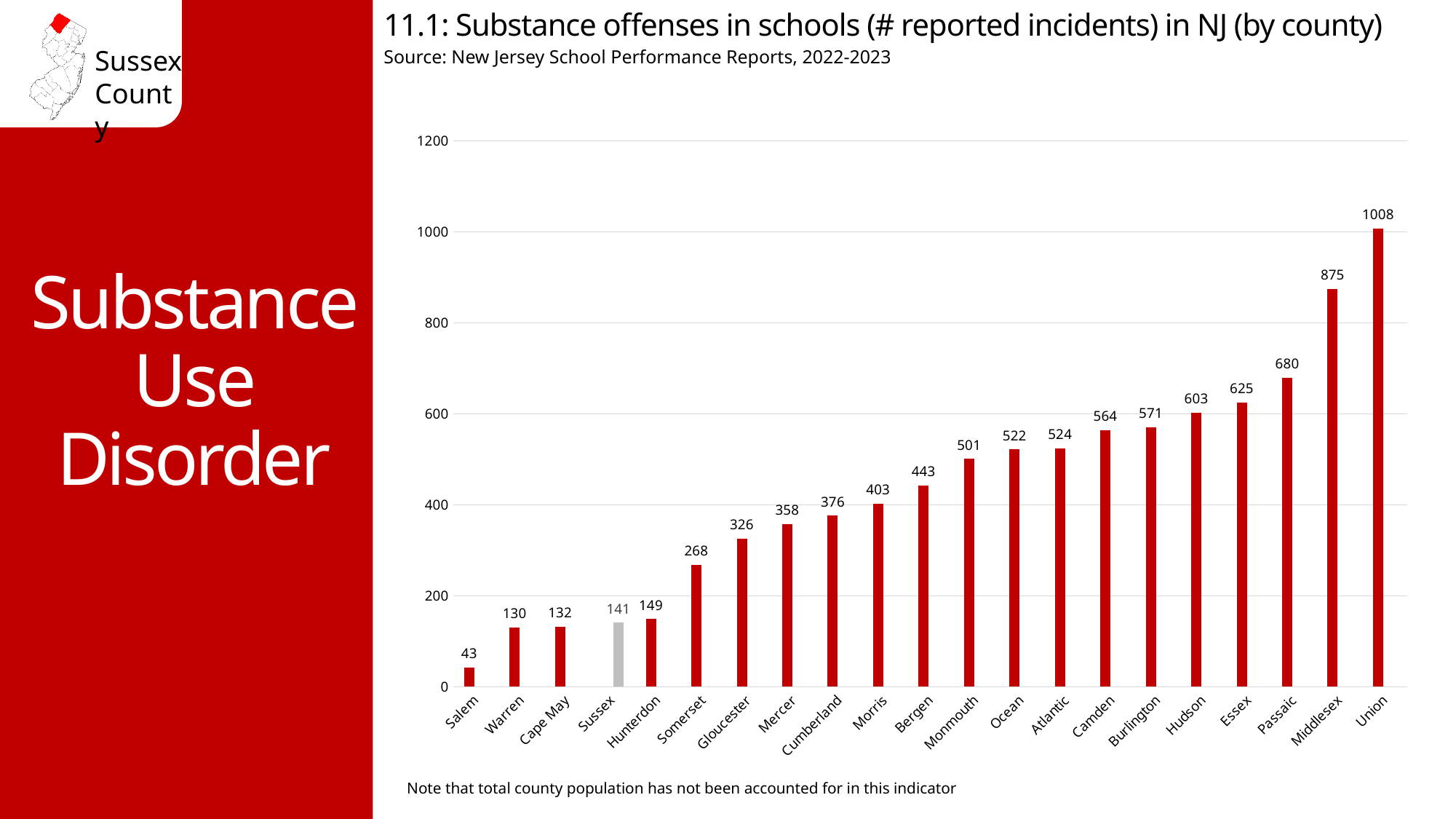
How many counties are shown on the chart? 21 What is the difference between the values for Union and Middlesex? 133 What is the value shown for Middlesex? 875 Which county's bar is coloured grey instead of red? Sussex Which has a higher value, Bergen or Morris? Bergen Which county has the highest number of reported incidents? Union Which county has the lowest number of reported incidents? Salem What is the difference between the values for Hunterdon and Sussex? 8 Do the values rise or fall moving from left to right along the x axis? Rise What is the number of reported substance offense incidents in schools for Sussex County? 141 What kind of chart is shown on the slide? Bar chart Is the value for Passaic greater or less than 600? greater